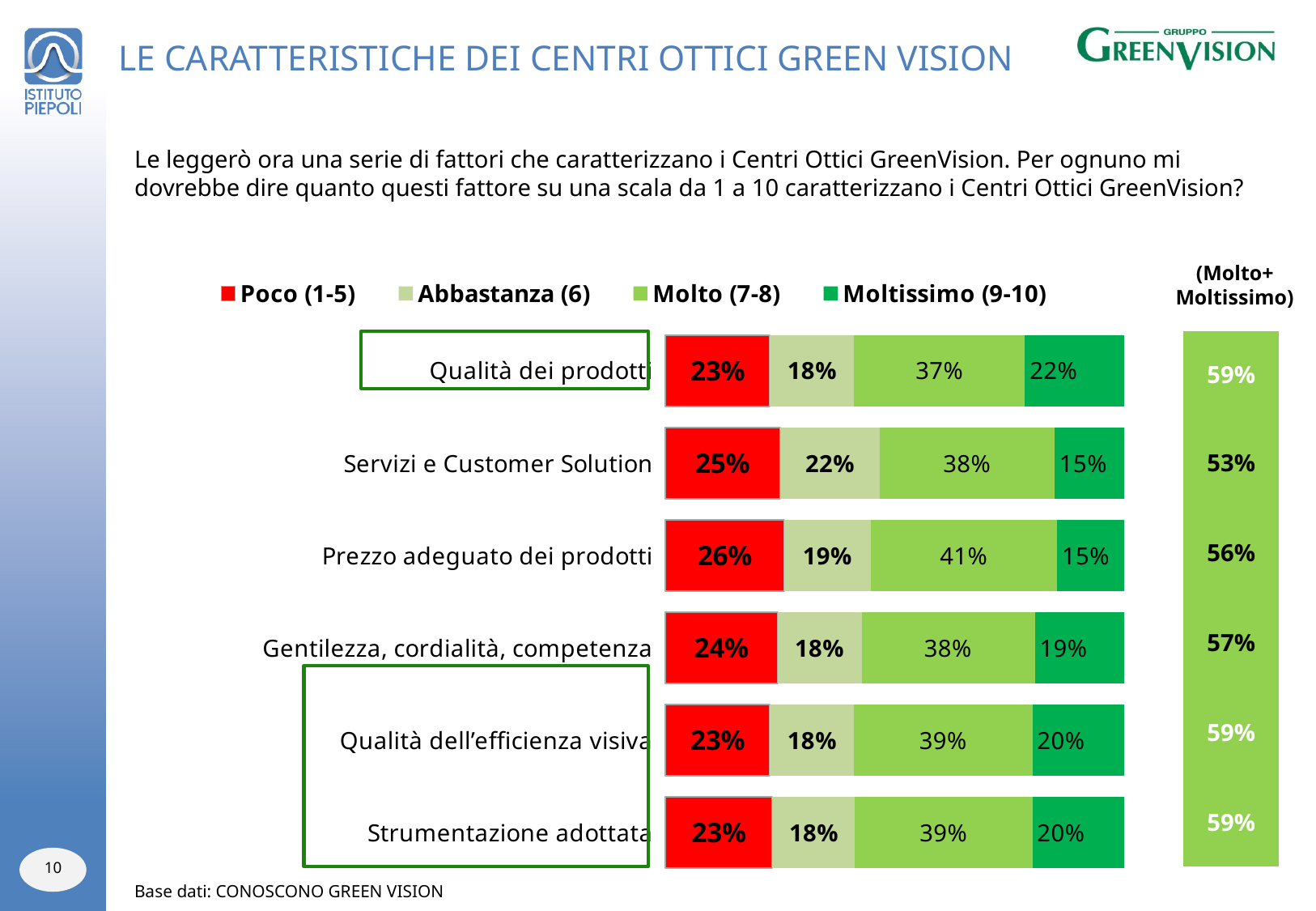
What is the Moltissimo (9-10) value for Qualità dei prodotti? 22% What colour represents Poco (1-5) in the legend? Red What is the Molto (7-8) value for Prezzo adeguato dei prodotti? 41% What is the (Molto+Moltissimo) value shown for Gentilezza, cordialità, competenza? 57% What kind of chart is shown on the slide? Stacked bar chart What is the difference between the (Molto+Moltissimo) values for Qualità dei prodotti and Servizi e Customer Solution? 6 percentage points How many series does the legend list? 4 Which category has the highest Poco (1-5) value? Prezzo adeguato dei prodotti Which category has the lowest (Molto+Moltissimo) value? Servizi e Customer Solution How many categories are shown in the chart? 6 What is the Abbastanza (6) value for Servizi e Customer Solution? 22% Which has the larger Moltissimo (9-10) value: Gentilezza, cordialità, competenza or Servizi e Customer Solution? Gentilezza, cordialità, competenza